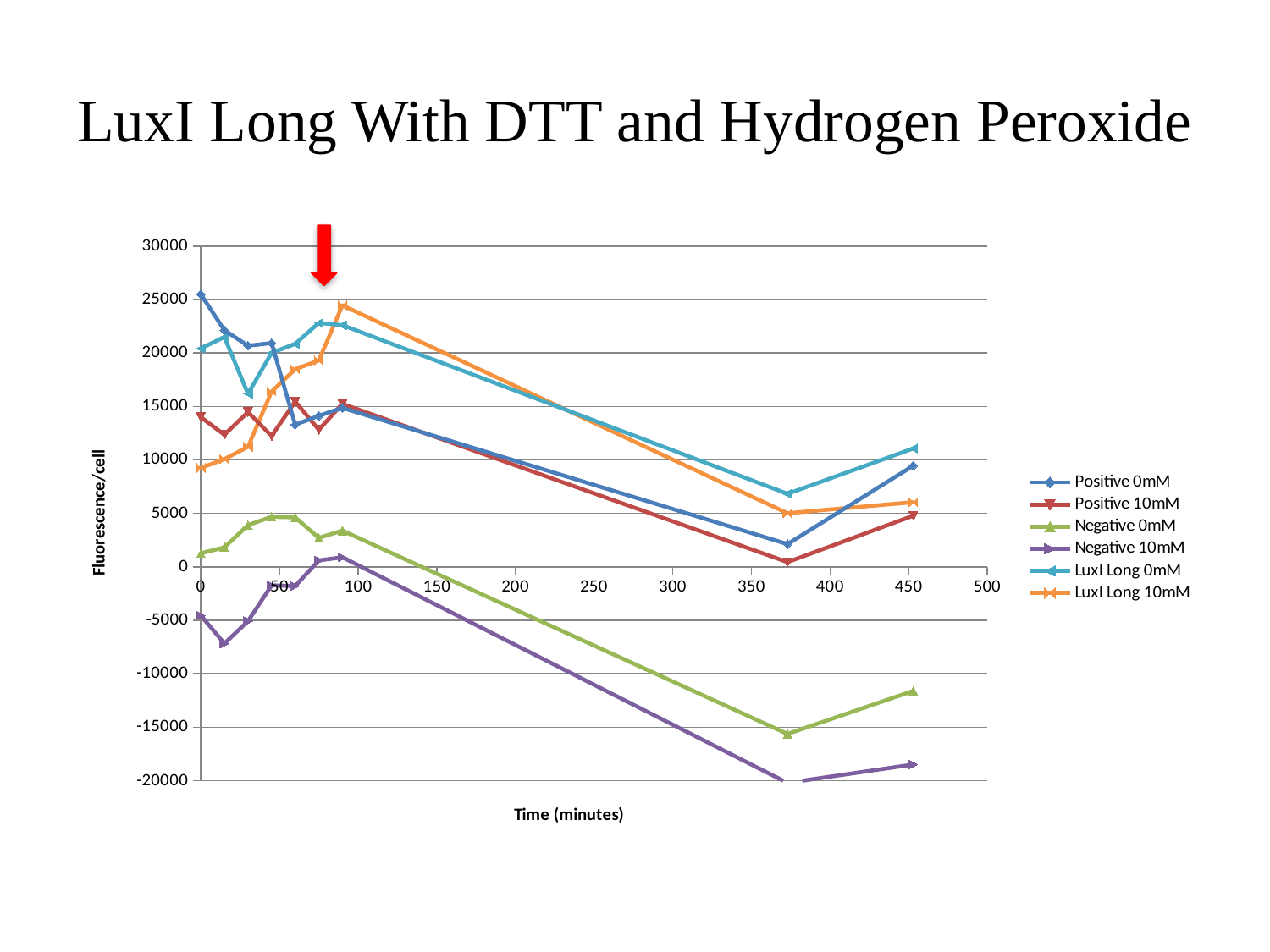
Is the value for Negative 0mM at around 375 minutes greater or less than -10000? less Does the Positive 10mM series rise or fall between about 375 and 450 minutes? rise How many series does the legend list? 6 What kind of chart is shown on the slide? line chart Is the value for Positive 10mM at around 375 minutes greater or less than 5000? less At around 450 minutes, which is higher: LuxI Long 0mM or Positive 0mM? LuxI Long 0mM Does the Negative 10mM series rise or fall between about 100 and 375 minutes? fall Which series has the lowest values across the chart? Negative 10mM Is the value for LuxI Long 10mM at around 90 minutes greater or less than 20000? greater What is the title of the y axis? Fluorescence/cell What is the title of the x axis? Time (minutes)